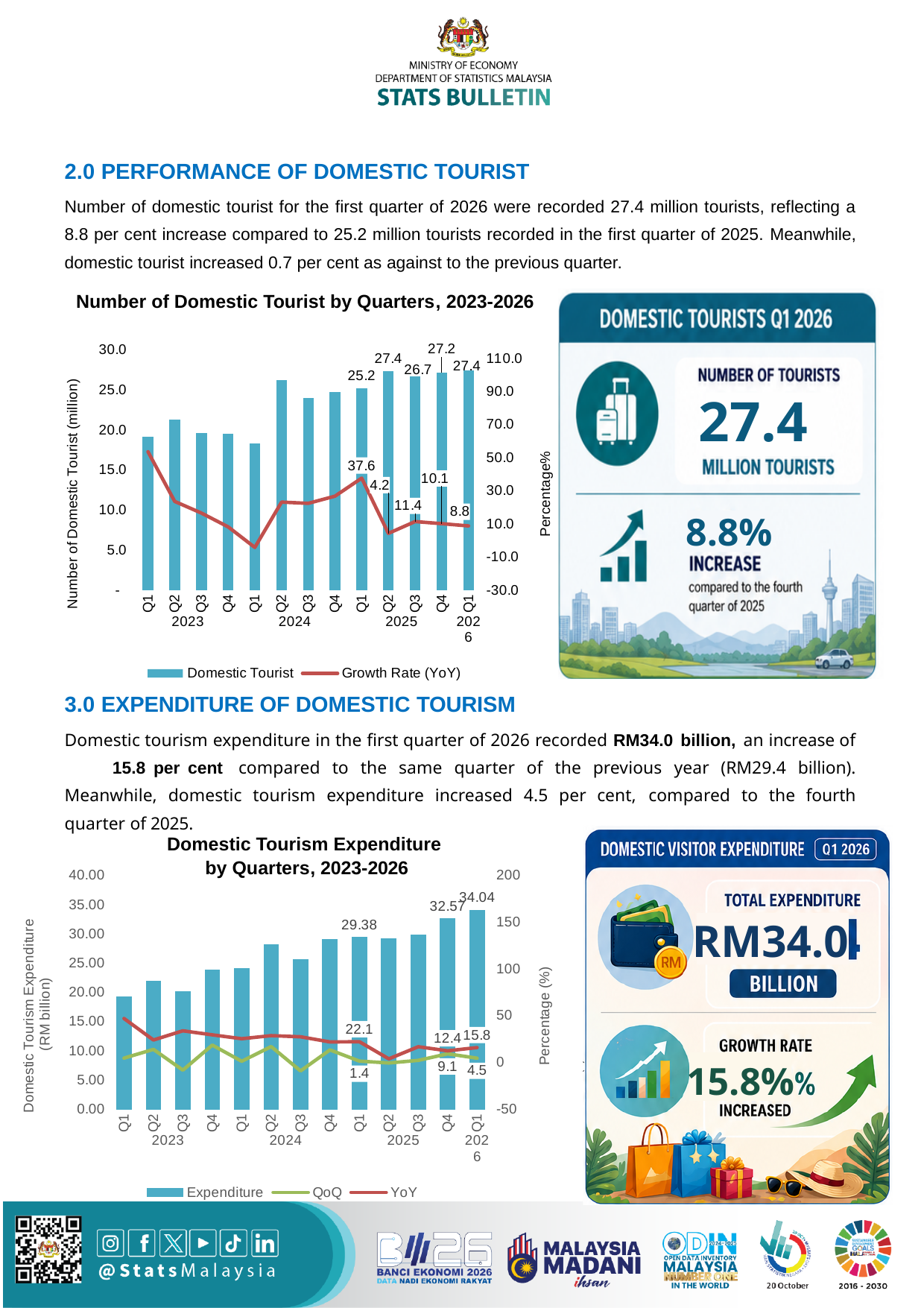
In the 'Number of Domestic Tourist by Quarters, 2023-2026' chart, how many series does the legend list? 2 In the 'Number of Domestic Tourist by Quarters, 2023-2026' chart, what is the difference between the Q1 2026 and Q1 2025 domestic tourist values? 2.2 In the 'Domestic Tourism Expenditure by Quarters, 2023-2026' chart, what is the difference between the Q1 2026 and Q1 2025 expenditure values? 4.66 In the 'Domestic Tourism Expenditure by Quarters, 2023-2026' chart, is the expenditure value for Q2 2024 greater or less than 25.00? greater In the 'Number of Domestic Tourist by Quarters, 2023-2026' chart, what is the Growth Rate (YoY) value for Q1 2025? 37.6 In the 'Number of Domestic Tourist by Quarters, 2023-2026' chart, which quarter has the higher domestic tourist value, Q2 2025 or Q3 2025? Q2 2025 What kind of chart is the 'Number of Domestic Tourist by Quarters, 2023-2026' chart? Combined bar and line chart In the 'Number of Domestic Tourist by Quarters, 2023-2026' chart, what is the number of domestic tourists for Q1 2026? 27.4 In the 'Domestic Tourism Expenditure by Quarters, 2023-2026' chart, what is the expenditure value for Q1 2026? 34.04 In the 'Domestic Tourism Expenditure by Quarters, 2023-2026' chart, what is the YoY value for Q1 2026? 15.8 In the 'Domestic Tourism Expenditure by Quarters, 2023-2026' chart, how many series does the legend list? 3 In the 'Number of Domestic Tourist by Quarters, 2023-2026' chart, how many quarters are plotted on the x axis? 13